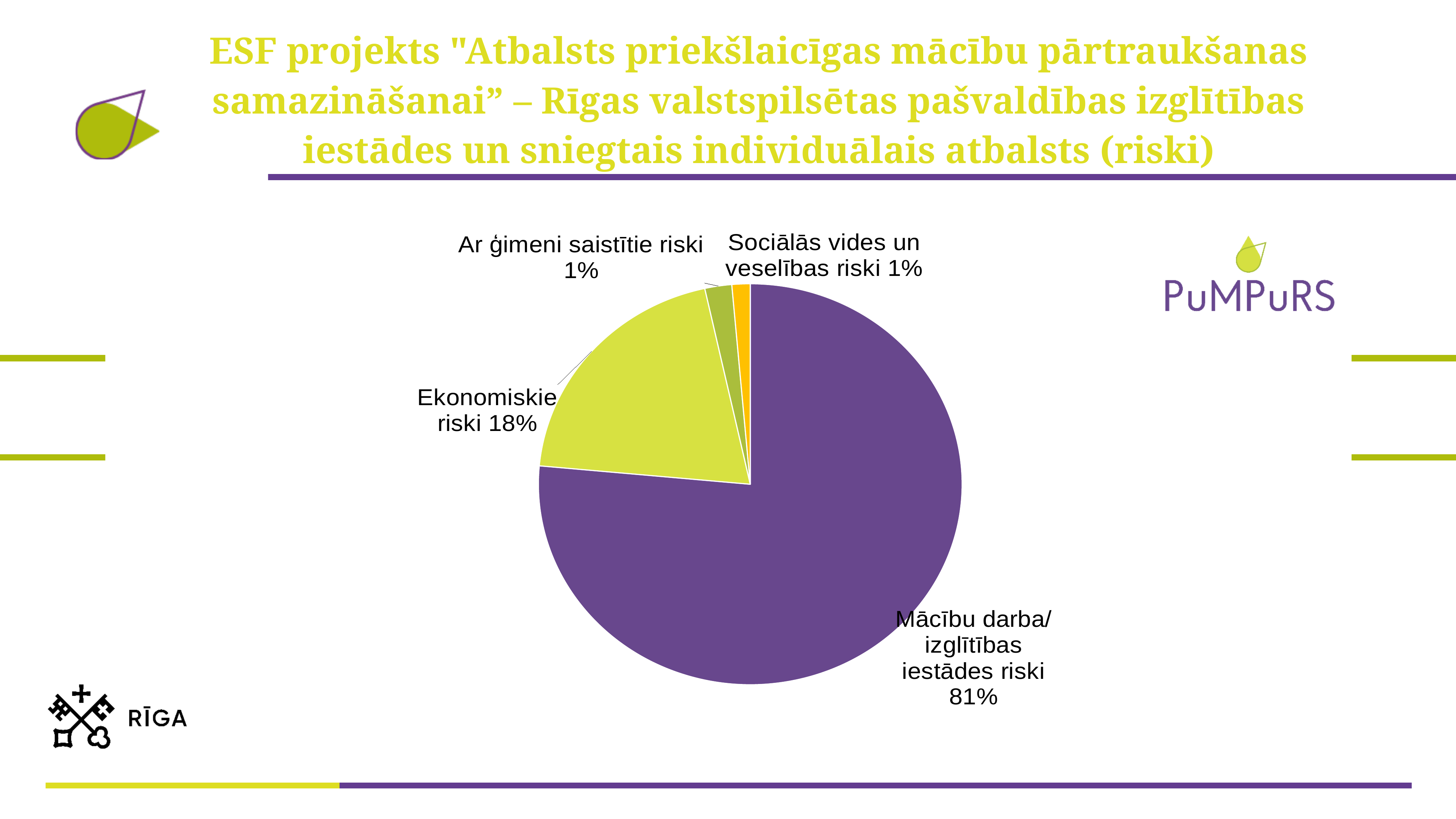
Which category has the largest slice of the pie? Mācību darba/ izglītības iestādes riski What kind of chart is shown on the slide? Pie chart What is the difference in percentage points between "Mācību darba/ izglītības iestādes riski" and "Ekonomiskie riski"? 63 What share of the pie does "Ar ģimeni saistītie riski" have? 1% What colour is the slice for "Ekonomiskie riski"? Yellow-green What is the difference in percentage points between "Ekonomiskie riski" and "Sociālās vides un veselības riski"? 17 What colour is the largest slice of the pie chart? Purple Which is larger, the slice for "Ekonomiskie riski" or the slice for "Ar ģimeni saistītie riski"? Ekonomiskie riski What share of the pie does "Sociālās vides un veselības riski" have? 1% What share of the pie does "Mācību darba/ izglītības iestādes riski" have? 81% How many slices does the pie chart have? 4